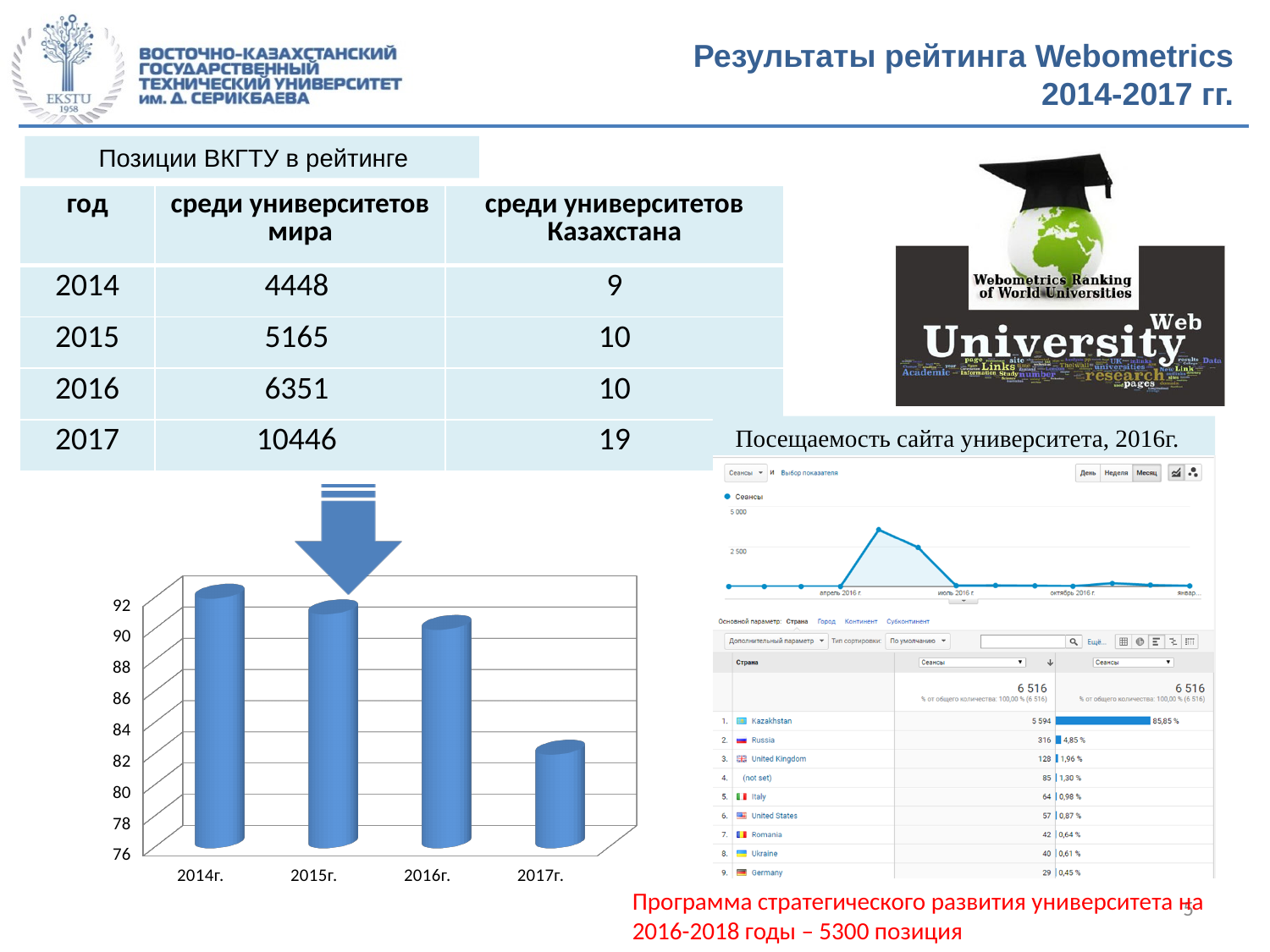
In the bar chart at the bottom left, is the value for 2017г. greater or less than 84? less In the site visits screenshot on the right (Посещаемость сайта университета, 2016г.), how many sessions are listed for Kazakhstan? 5 594 In the bar chart at the bottom left, how many categories are shown on the x axis? 4 In the site visits screenshot on the right (Посещаемость сайта университета, 2016г.), what share of sessions comes from Kazakhstan? 85,85 % What kind of chart is the chart at the bottom left of the slide? bar chart In the bar chart at the bottom left, which is larger, the value for 2016г. or the value for 2017г.? 2016г. In the bar chart at the bottom left, which category has the lowest bar? 2017г. In the bar chart at the bottom left, is the value for 2014г. greater or less than 90? greater In the bar chart at the bottom left, which category has the highest bar? 2014г. In the bar chart at the bottom left, what is the lowest tick value shown on the y axis? 76 In the bar chart at the bottom left, do the values rise or fall from 2014г. to 2017г.? fall In the bar chart at the bottom left, is the value for 2016г. greater or less than 88? greater